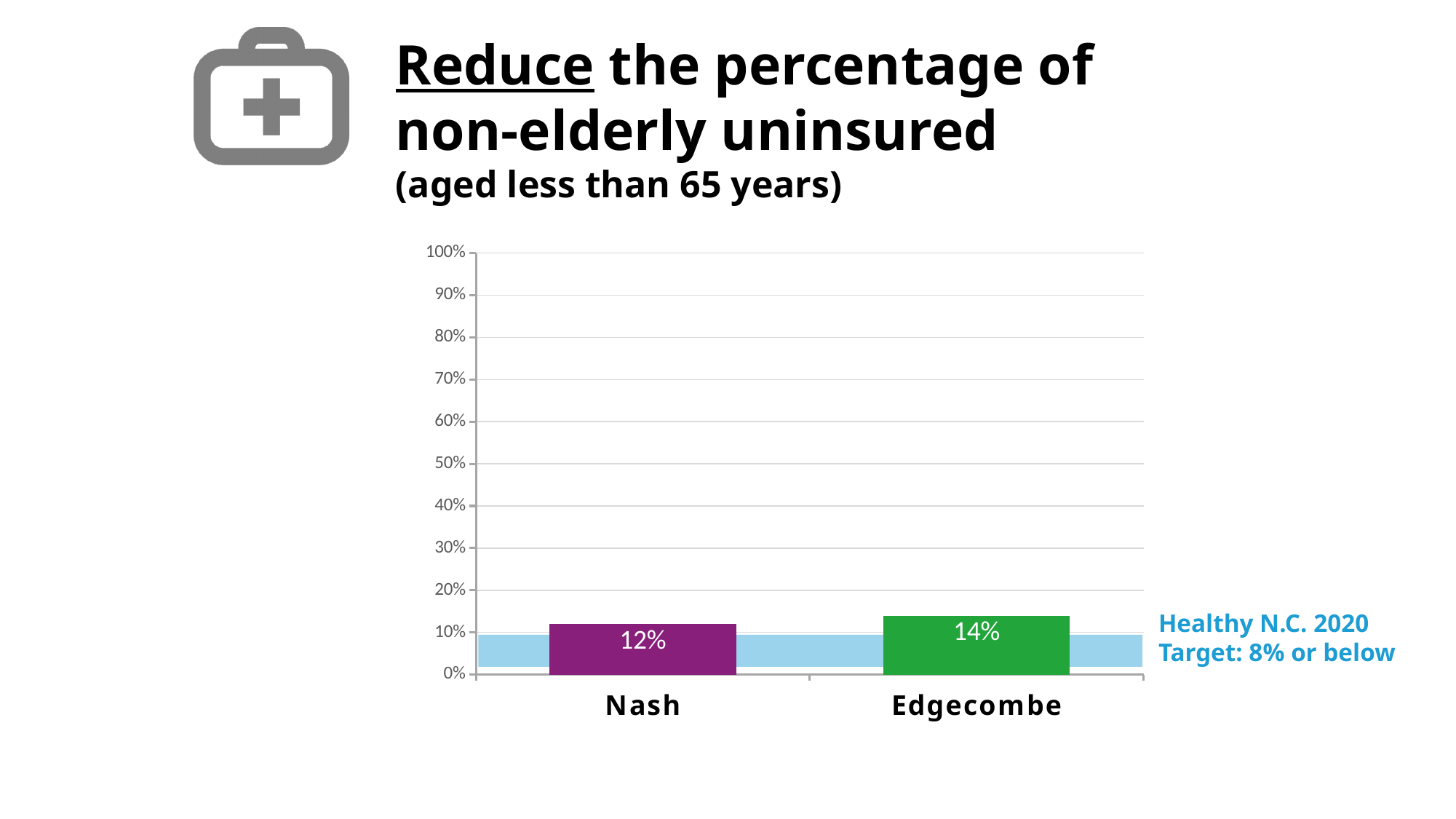
Is the value for Edgecombe greater or less than 20%? less How many counties are shown on the chart? 2 What is the highest value shown on the y axis? 100% What kind of chart is shown on the slide? bar chart What is the percentage of non-elderly uninsured for Nash? 12% What is the difference in percentage points between Edgecombe and Nash? 2% Which county has the higher percentage of non-elderly uninsured? Edgecombe What is the Healthy N.C. 2020 target shown next to the chart? 8% or below Which county has the lower percentage of non-elderly uninsured? Nash Is the value for Nash larger or smaller than the value for Edgecombe? smaller Is the value for Nash greater or less than 10%? greater What is the percentage of non-elderly uninsured for Edgecombe? 14%